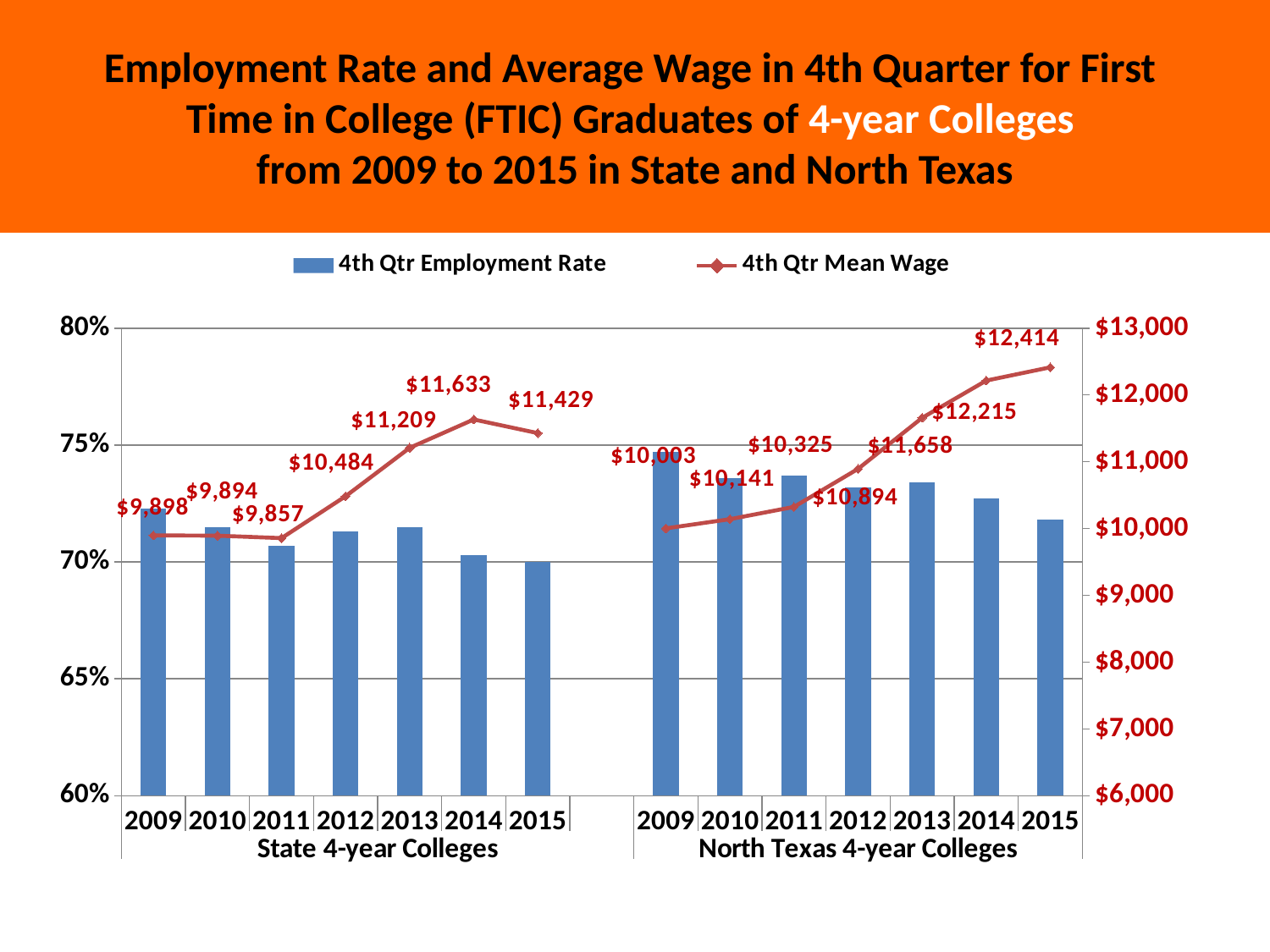
Is the 4th Qtr Employment Rate for North Texas 4-year Colleges in 2009 greater or less than 70%? greater Does the 4th Qtr Mean Wage for North Texas 4-year Colleges rise or fall from 2009 to 2015? rise Which year and group has the highest 4th Qtr Mean Wage on the chart? North Texas 4-year Colleges, 2015 Which is larger, the 4th Qtr Mean Wage for State 4-year Colleges in 2014 or in 2015? 2014 Is the 4th Qtr Employment Rate for State 4-year Colleges in 2015 greater or less than 75%? less How many years are shown for each college group on the chart? 7 What is the 4th Qtr Mean Wage for North Texas 4-year Colleges in 2015? $12,414 Which year has the lowest 4th Qtr Mean Wage for State 4-year Colleges? 2011 What is the difference between the 4th Qtr Mean Wage for North Texas 4-year Colleges in 2015 and in 2009? $2,411 What is the 4th Qtr Mean Wage for North Texas 4-year Colleges in 2009? $10,003 How many series does the legend list? 2 What is the 4th Qtr Mean Wage for State 4-year Colleges in 2013? $11,209